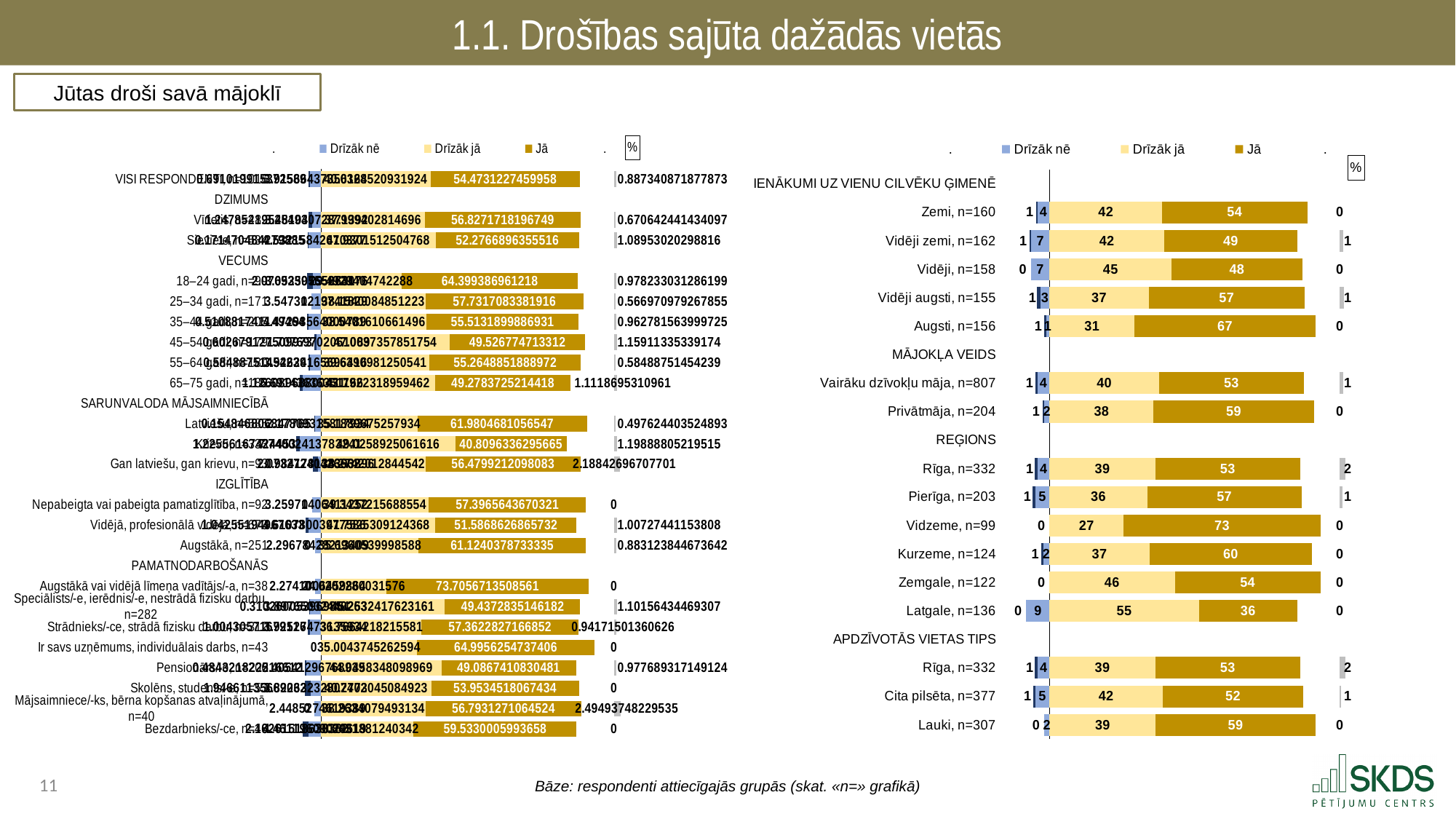
In the right-hand chart, which region under REĢIONS has the lowest "Jā" value? Latgale, n=136 What kind of chart is the right-hand chart? Stacked horizontal bar chart How many series does the legend of the right-hand chart list? 3 In the right-hand chart, how many income groups are listed under IENĀKUMI UZ VIENU CILVĒKU ĢIMENĒ? 5 In the right-hand chart, what is the "Drīzāk nē" value for "Latgale, n=136"? 9 In the right-hand chart, what is the "Jā" value for the income group "Augsti, n=156"? 67 In the right-hand chart, what is the "Jā" value for "Vidzeme, n=99"? 73 In the right-hand chart, what is the "Drīzāk jā" value for "Zemgale, n=122"? 46 In the right-hand chart, what is the difference between the "Jā" values for "Privātmāja, n=204" and "Vairāku dzīvokļu māja, n=807"? 6 In the right-hand chart, what is the "Jā" value for "Lauki, n=307"? 59 In the right-hand chart, which has the larger "Drīzāk jā" value: "Latgale, n=136" or "Vidzeme, n=99"? Latgale, n=136 In the right-hand chart, which region under REĢIONS has the highest "Jā" value? Vidzeme, n=99